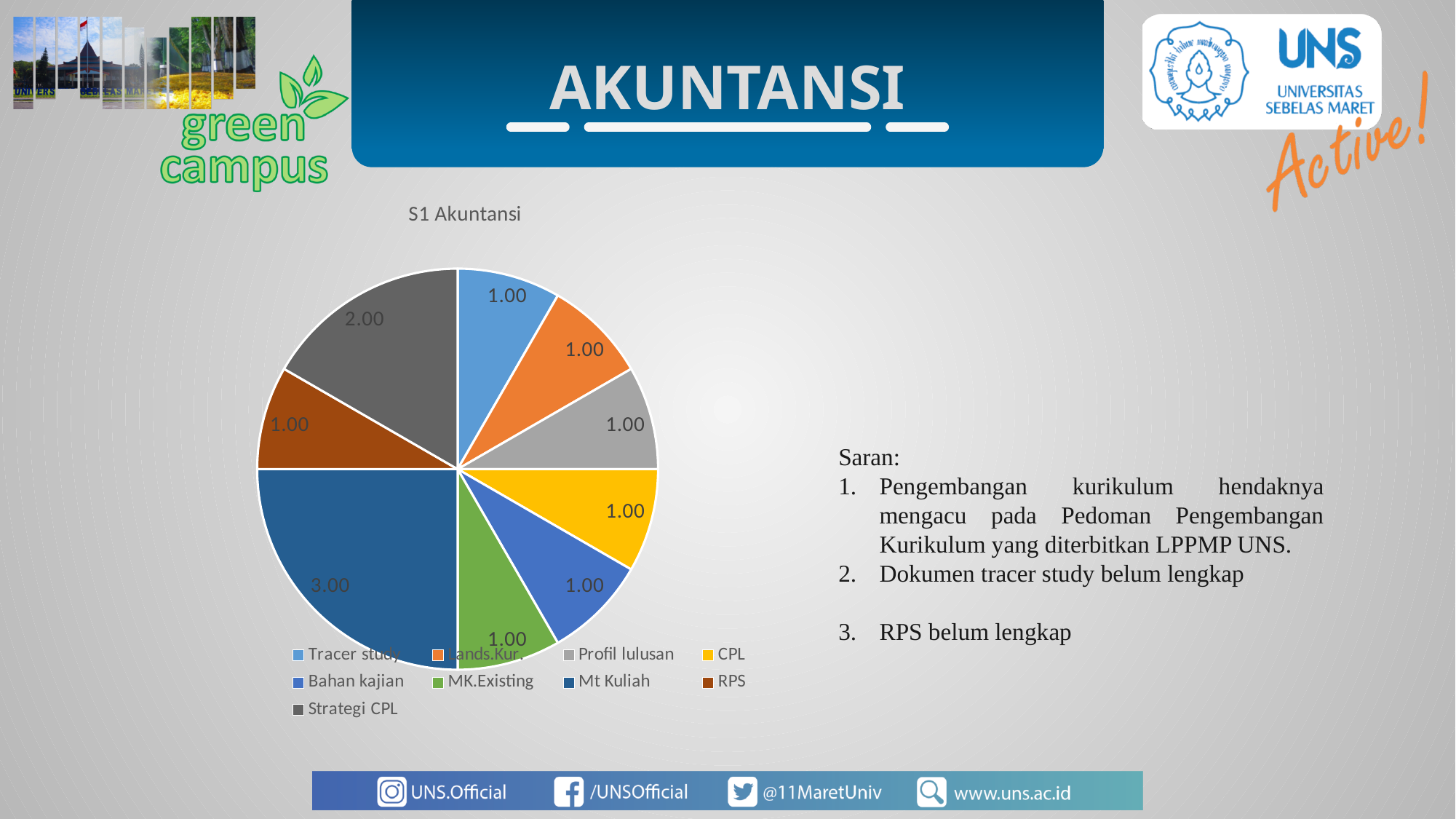
How many categories in the pie chart have a value of 1.00? 7 What is the title of the chart? S1 Akuntansi How many categories does the pie chart have? 9 What kind of chart is shown on the slide? pie chart What is the total of all the slice values in the pie chart? 12.00 What is the value for Strategi CPL? 2.00 What share of the pie does Mt Kuliah represent? 25% Which is larger, the value for Mt Kuliah or the value for RPS? Mt Kuliah Which category has the largest slice of the pie? Mt Kuliah What is the difference between the values for Mt Kuliah and Strategi CPL? 1.00 What is the value for Mt Kuliah? 3.00 What is the value for CPL? 1.00